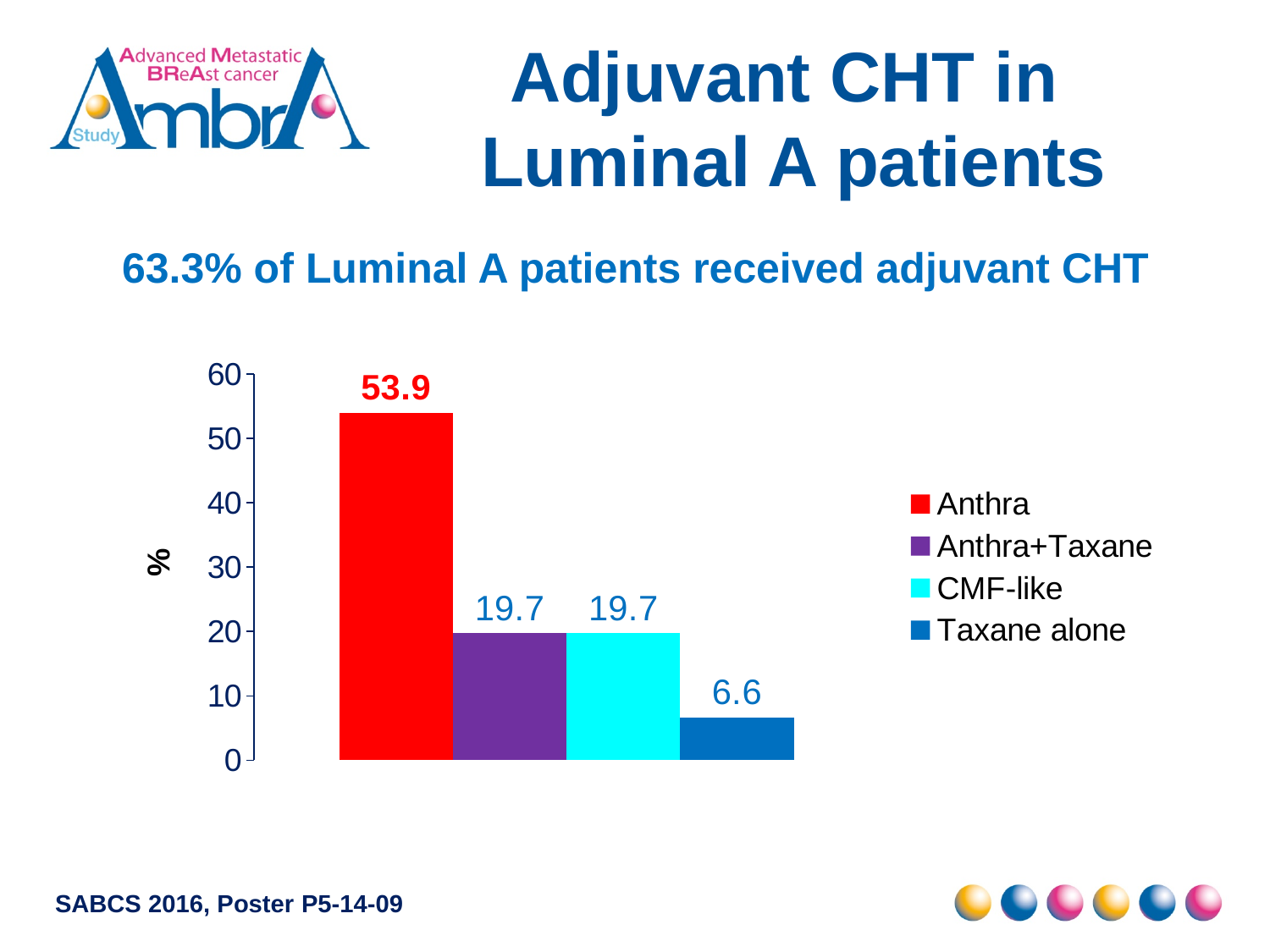
What is the difference between the values for Anthra and Anthra+Taxane? 34.2 Which regimen has the lowest value? Taxane alone Which regimen has the highest value? Anthra What is the value for CMF-like? 19.7 Which is larger, the value for Anthra+Taxane or the value for Taxane alone? Anthra+Taxane What kind of chart is shown on the slide? bar chart What is the difference between the values for Anthra and Taxane alone? 47.3 Is the value for Anthra greater or less than 50? greater How many series does the legend list? 4 What is the value for Anthra? 53.9 What is the label on the vertical axis? % What is the value for Taxane alone? 6.6